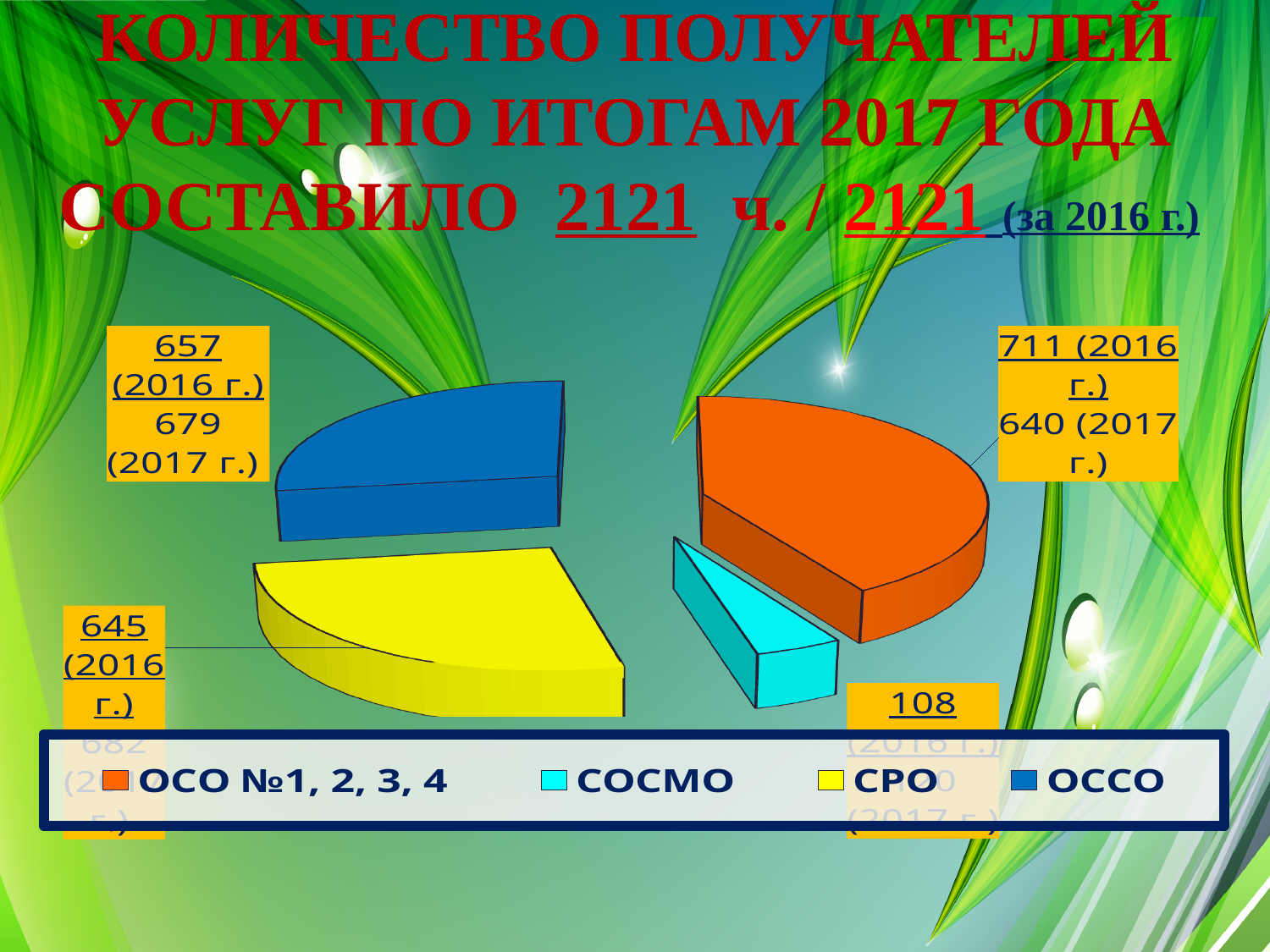
What was the number of service recipients for ОСО №1, 2, 3, 4 in 2016 according to the data label? 711 What was the number of service recipients for СОСМО in 2016 according to the data label? 108 Which slice of the pie chart is the smallest? СОСМО What was the number of service recipients for ОССО in 2017 according to the data label? 679 What was the number of service recipients for СРО in 2016 according to the data label? 645 What was the number of service recipients for ОСО №1, 2, 3, 4 in 2017 according to the data label? 640 Which colour represents СРО in the pie chart? yellow What kind of chart is shown on the slide? pie chart What was the number of service recipients for ОССО in 2016 according to the data label? 657 What is the difference between the 2016 values for ОСО №1, 2, 3, 4 and ОССО? 54 How many slices does the pie chart have? 4 How many categories does the legend of the pie chart list? 4